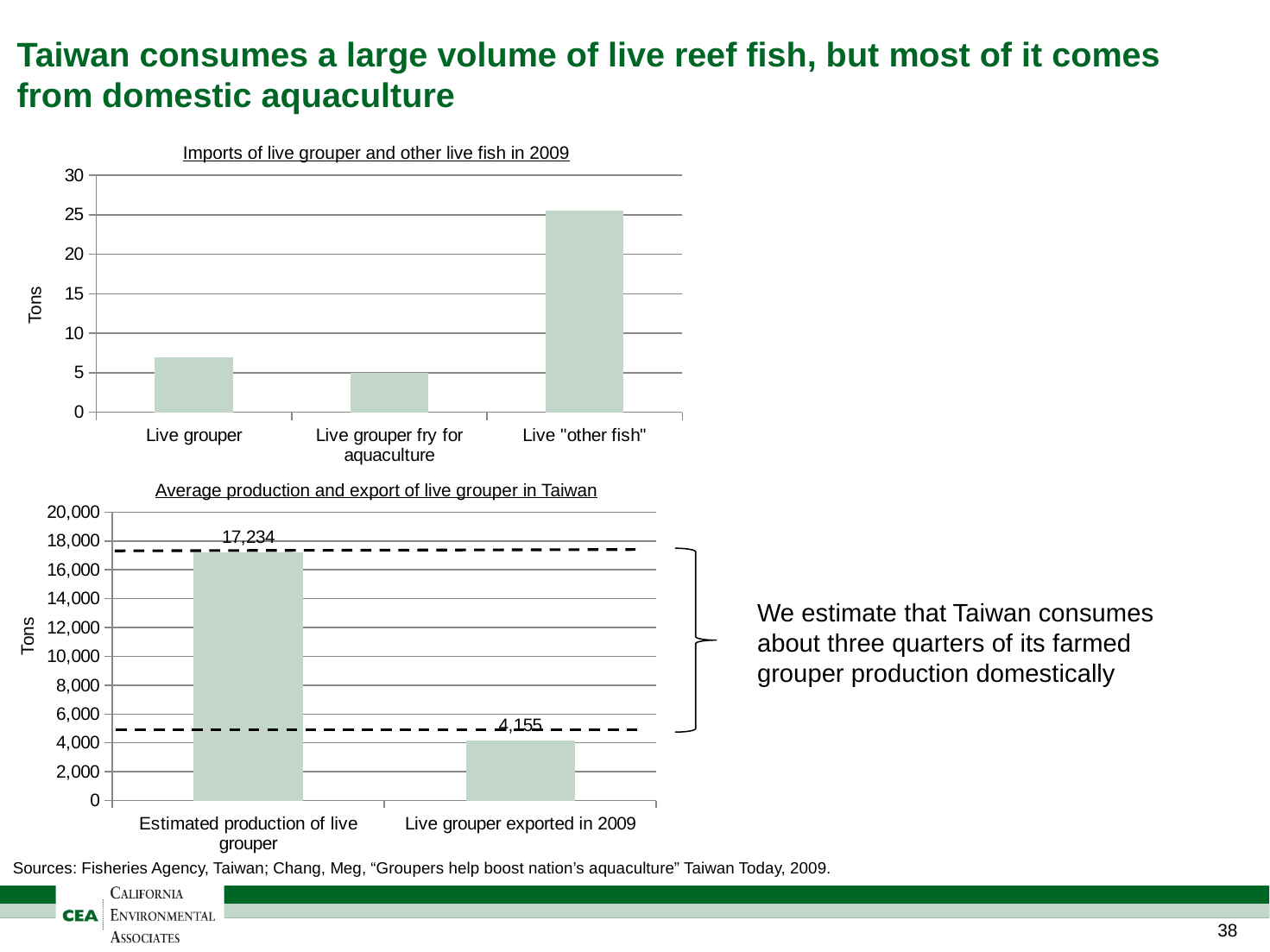
In the chart 'Imports of live grouper and other live fish in 2009', which category has the highest value? Live "other fish" In the chart 'Imports of live grouper and other live fish in 2009', which is larger: the value for Live grouper or the value for Live grouper fry for aquaculture? Live grouper In the chart 'Average production and export of live grouper in Taiwan', what is the difference between the estimated production of live grouper and the live grouper exported in 2009? 13,079 In the chart 'Imports of live grouper and other live fish in 2009', is the value for Live grouper greater or less than 10? less What kind of chart is the top chart on the slide? Bar chart What unit is shown on the y axis of the chart 'Average production and export of live grouper in Taiwan'? Tons How many bars are shown in the chart 'Average production and export of live grouper in Taiwan'? 2 In the chart 'Imports of live grouper and other live fish in 2009', which category has the lowest value? Live grouper fry for aquaculture In the chart 'Imports of live grouper and other live fish in 2009', is the value for Live "other fish" greater or less than 20? greater In the chart 'Average production and export of live grouper in Taiwan', what is the value for 'Estimated production of live grouper'? 17,234 How many categories are shown in the chart 'Imports of live grouper and other live fish in 2009'? 3 In the chart 'Average production and export of live grouper in Taiwan', what is the value for 'Live grouper exported in 2009'? 4,155